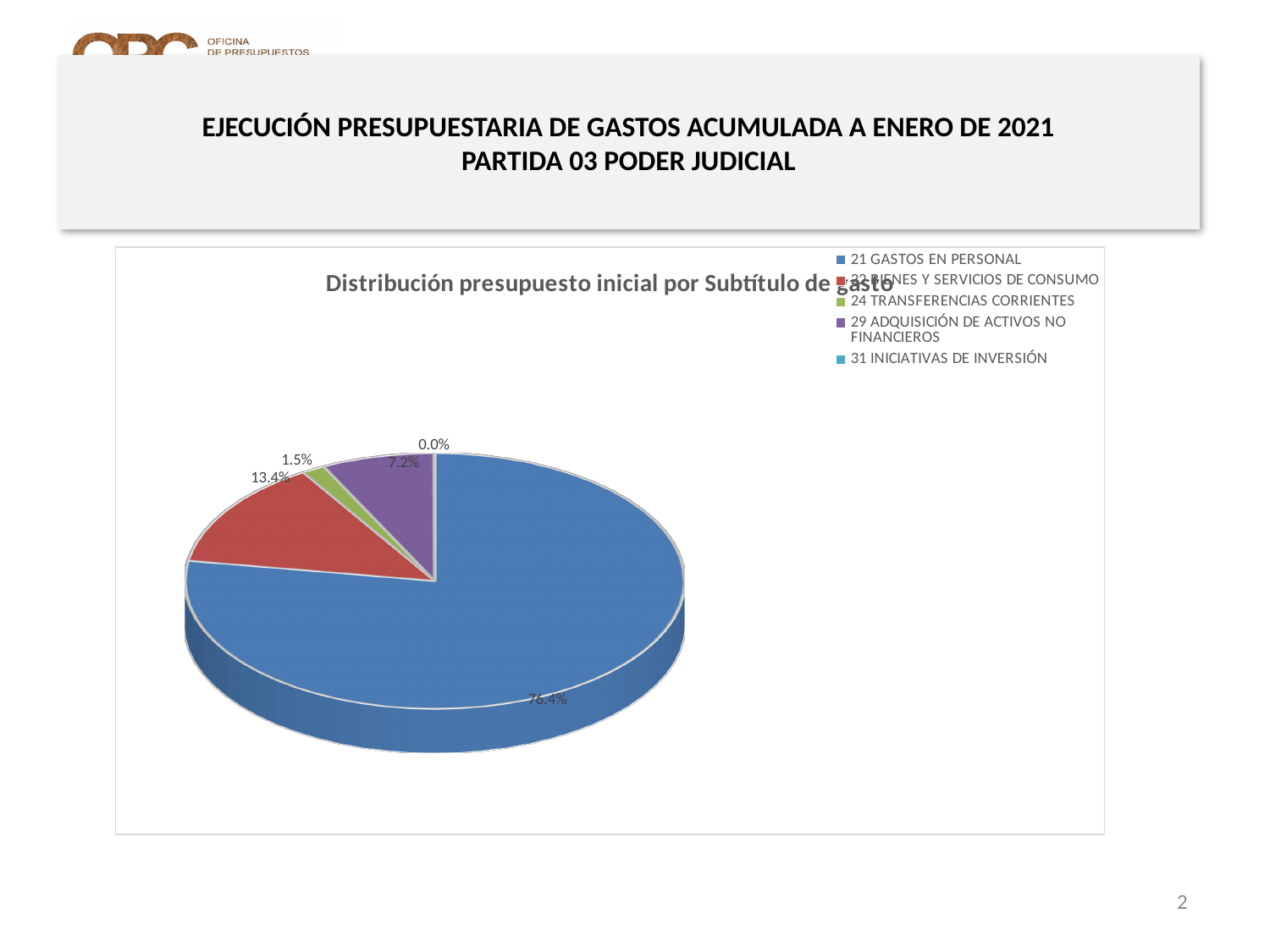
What is the difference in percentage points between the share for 21 GASTOS EN PERSONAL and the share for 22 BIENES Y SERVICIOS DE CONSUMO? 63.0 percentage points What share of the pie does 21 GASTOS EN PERSONAL represent? 76.4% What kind of chart is shown on the slide? Pie chart What share of the pie does 24 TRANSFERENCIAS CORRIENTES represent? 1.5% How many entries does the legend list? 5 Which category has the smallest share of the pie? 31 INICIATIVAS DE INVERSIÓN What share of the pie does 31 INICIATIVAS DE INVERSIÓN represent? 0.0% Which category has the largest share of the pie? 21 GASTOS EN PERSONAL What is the chart's title? Distribución presupuesto inicial por Subtítulo de gasto Which is larger, the share for 22 BIENES Y SERVICIOS DE CONSUMO or the share for 29 ADQUISICIÓN DE ACTIVOS NO FINANCIEROS? 22 BIENES Y SERVICIOS DE CONSUMO